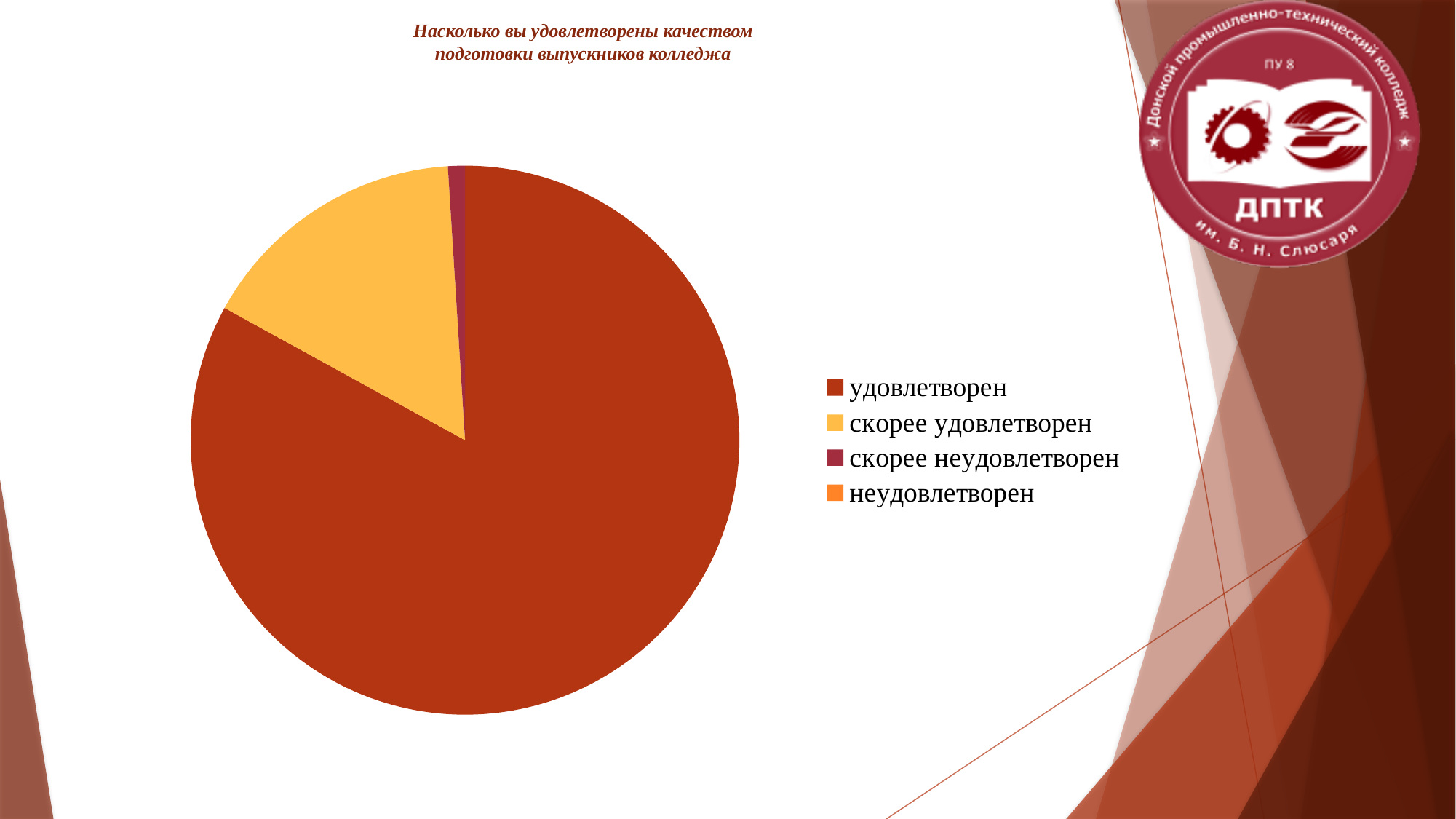
Which is larger, the slice for скорее удовлетворен or the slice for скорее неудовлетворен? скорее удовлетворен What kind of chart is shown on the slide? pie chart Which category is shown in yellow in the legend? скорее удовлетворен How many categories does the chart legend list? 4 Which category has the largest slice of the pie? удовлетворен Which category has the second-largest slice of the pie? скорее удовлетворен What is the title of the chart? Насколько вы удовлетворены качеством подготовки выпускников колледжа Does the slice for удовлетворен take up more or less than half of the pie? more